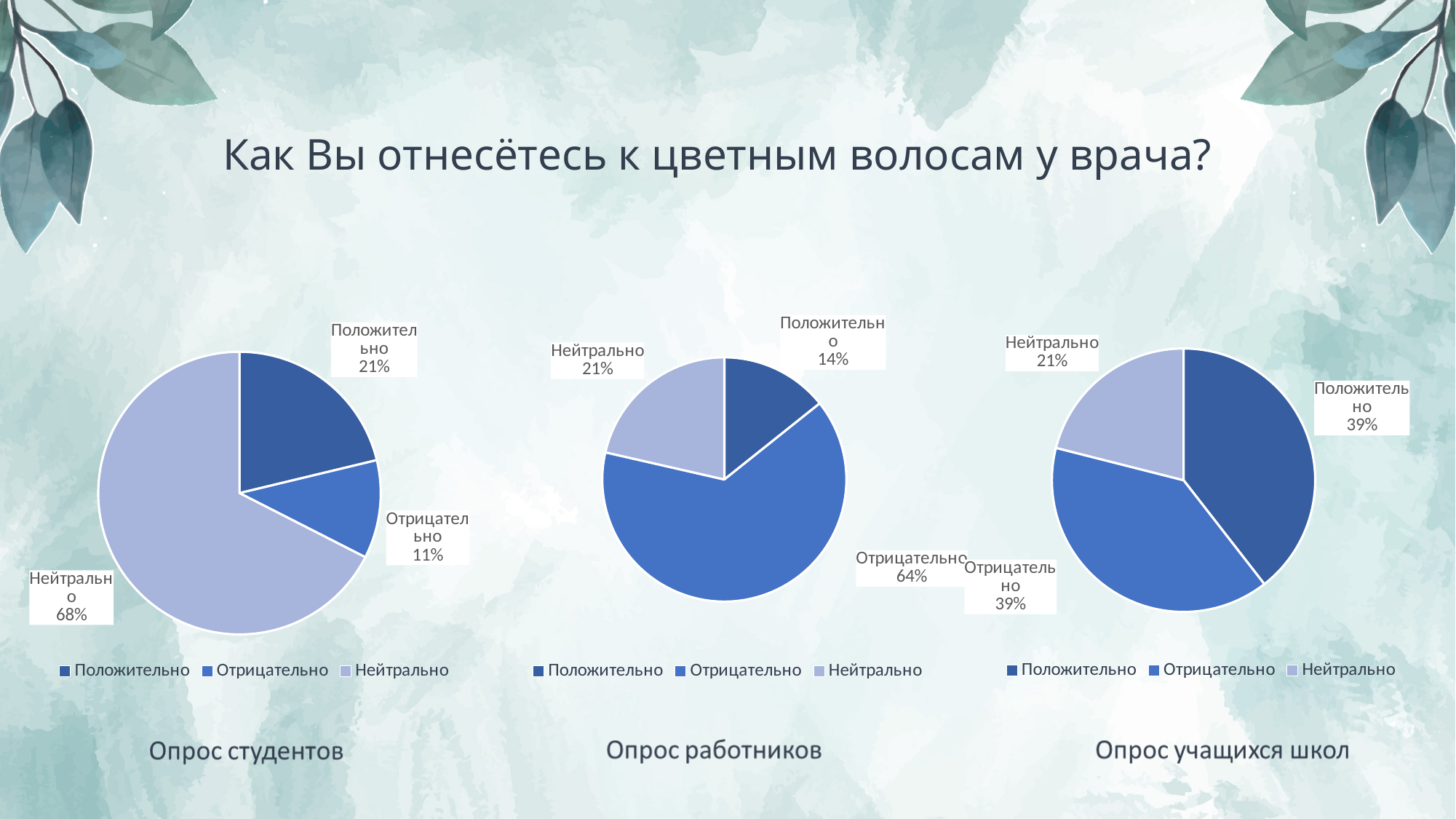
In the 'Опрос студентов' chart, what percentage is labelled for Отрицательно? 11% In the 'Опрос работников' chart, which is larger: Отрицательно or Нейтрально? Отрицательно In the 'Опрос студентов' chart, what is the difference in percentage points between Нейтрально and Положительно? 47 How many categories does the legend of the 'Опрос учащихся школ' chart list? 3 What type of chart is used for 'Опрос работников'? Pie chart In the 'Опрос учащихся школ' chart, what percentage is labelled for Нейтрально? 21% In the 'Опрос студентов' chart, what percentage is labelled for Нейтрально? 68% In the 'Опрос работников' chart, what percentage is labelled for Положительно? 14% In the 'Опрос учащихся школ' chart, which category has the smallest slice? Нейтрально In the 'Опрос студентов' chart, which category has the largest slice? Нейтрально In the 'Опрос работников' chart, what percentage is labelled for Отрицательно? 64% In the 'Опрос работников' chart, which category has the smallest slice? Положительно